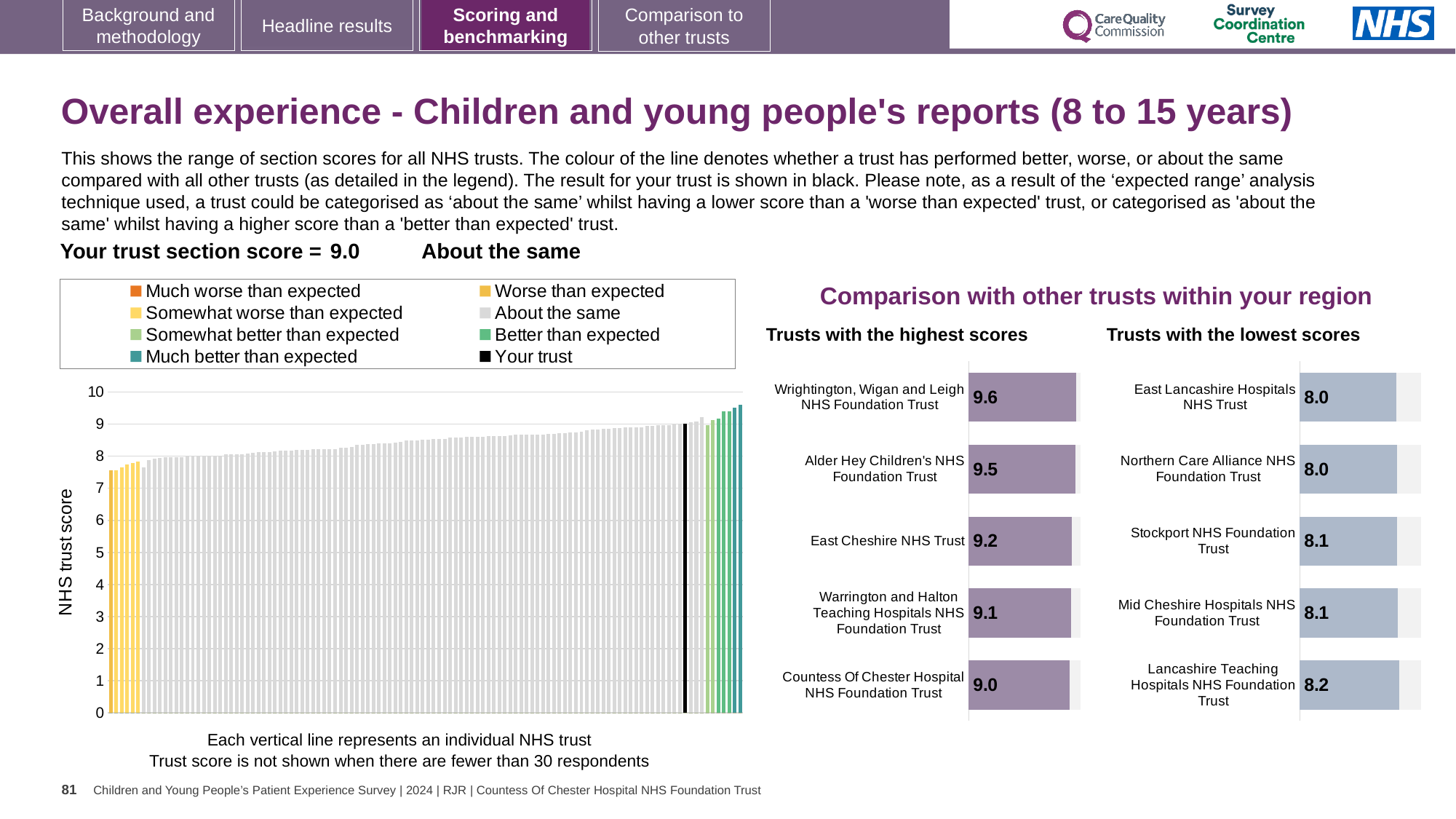
How many entries does the legend of the large chart on the left list? 8 In the 'Trusts with the highest scores' chart, what is the difference between the scores of Wrightington, Wigan and Leigh NHS Foundation Trust and Countess Of Chester Hospital NHS Foundation Trust? 0.6 What kind of chart is the large chart on the left showing NHS trust scores? Bar chart In the 'Trusts with the highest scores' chart, what is the score for Wrightington, Wigan and Leigh NHS Foundation Trust? 9.6 In the large chart on the left, do the bar heights rise or fall from left to right? Rise In the 'Trusts with the lowest scores' chart, what is the difference between the scores of Lancashire Teaching Hospitals NHS Foundation Trust and East Lancashire Hospitals NHS Trust? 0.2 In the 'Trusts with the lowest scores' chart, what is the score for Lancashire Teaching Hospitals NHS Foundation Trust? 8.2 In the 'Trusts with the highest scores' chart, which trust has the highest score? Wrightington, Wigan and Leigh NHS Foundation Trust In the 'Trusts with the highest scores' chart, which has the larger score: Alder Hey Children's NHS Foundation Trust or Warrington and Halton Teaching Hospitals NHS Foundation Trust? Alder Hey Children's NHS Foundation Trust How many trusts are listed in the 'Trusts with the lowest scores' chart? 5 In the 'Trusts with the highest scores' chart, what is the score for East Cheshire NHS Trust? 9.2 In the 'Trusts with the lowest scores' chart, what is the score for Stockport NHS Foundation Trust? 8.1